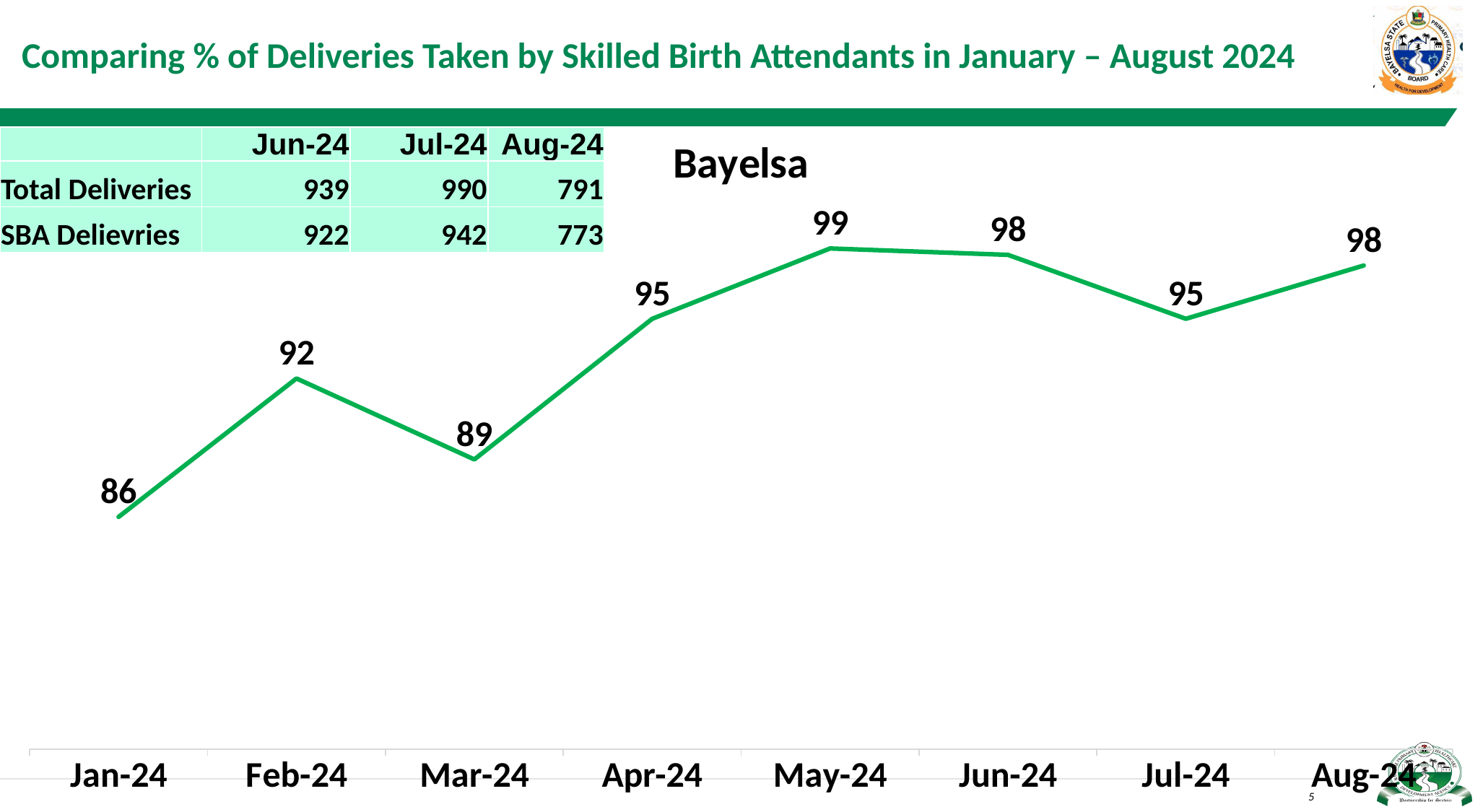
What is the value for Mar-24 on the Bayelsa line chart? 89 Which month has the lowest value on the Bayelsa line chart? Jan-24 Does the value on the Bayelsa line chart rise or fall from Jun-24 to Jul-24? Fall What is the value for Jan-24 on the Bayelsa line chart? 86 Which is larger on the Bayelsa line chart, the value for Feb-24 or the value for Apr-24? Apr-24 What is the difference between the values for Feb-24 and Mar-24 on the Bayelsa line chart? 3 What is the value for May-24 on the Bayelsa line chart? 99 Which month has the highest value on the Bayelsa line chart? May-24 What is the title shown above the line chart? Bayelsa What kind of chart is shown on the slide? Line chart What is the difference between the values for May-24 and Jan-24 on the Bayelsa line chart? 13 How many months are plotted on the Bayelsa line chart? 8